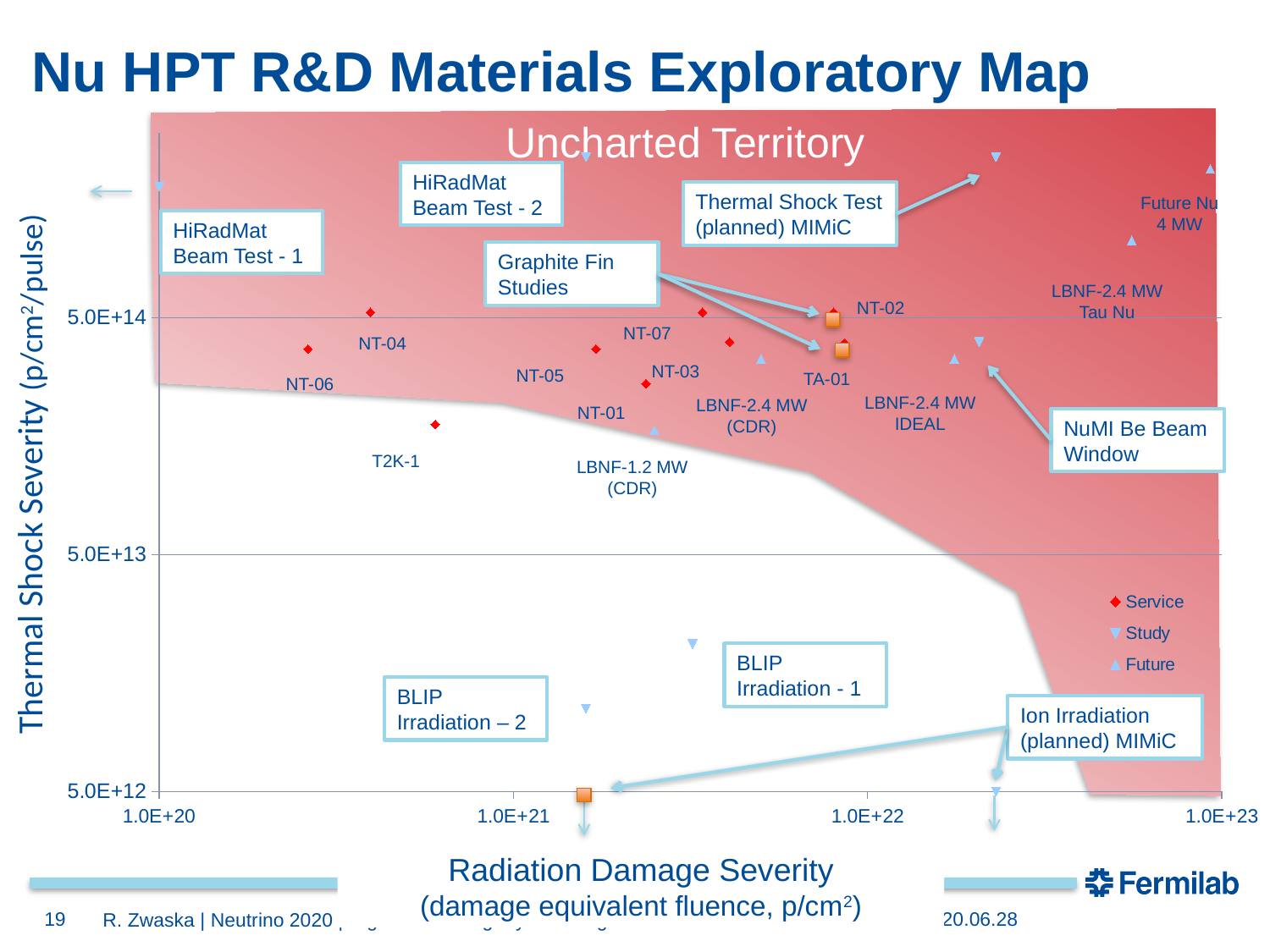
What are the three series named in the chart legend? Service, Study, Future Is the radiation damage severity for LBNF-2.4 MW IDEAL greater or less than 1.0E+22? greater Is the thermal shock severity for BLIP Irradiation - 1 greater or less than 5.0E+13? less Which labeled point has the lowest thermal shock severity? Ion Irradiation (planned) MIMiC Which has the higher thermal shock severity, NT-02 or T2K-1? NT-02 Which labeled point has the highest radiation damage severity? Future Nu 4 MW What is the label of the y axis of the chart? Thermal Shock Severity (p/cm2/pulse) Is the thermal shock severity for T2K-1 greater or less than 5.0E+14? less What kind of chart is shown on the slide? scatter chart How many series does the chart legend list? 3